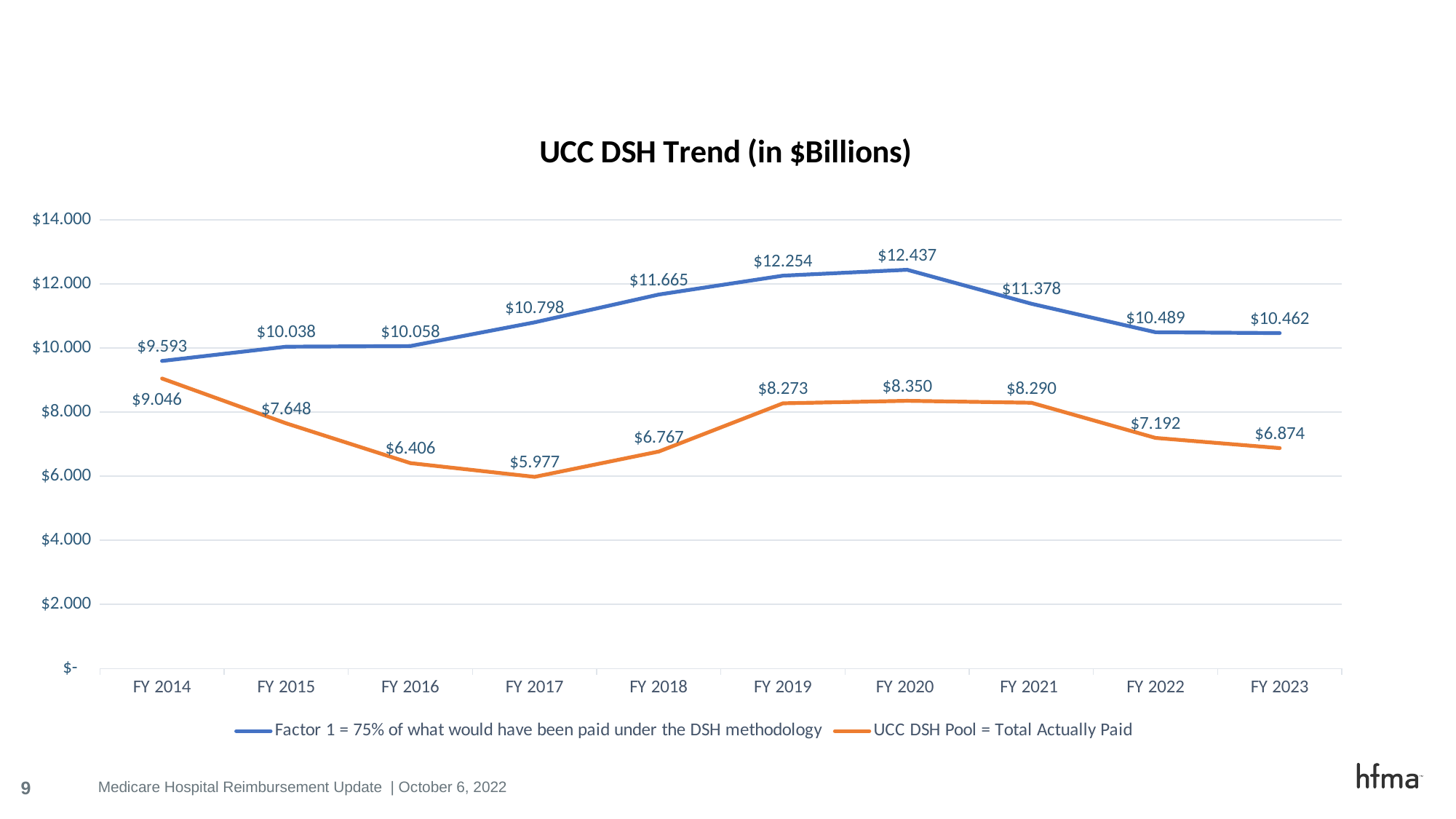
In which fiscal year is the UCC DSH Pool series lowest? FY 2017 What is the UCC DSH Pool value for FY 2023? $6.874 Which is larger in FY 2019: the Factor 1 value or the UCC DSH Pool value? Factor 1 What kind of chart is shown on the slide? Line chart What is the difference between the Factor 1 value and the UCC DSH Pool value in FY 2014? $0.547 How many fiscal years are plotted on the x axis? 10 What is the Factor 1 value for FY 2020? $12.437 What is the UCC DSH Pool value for FY 2017? $5.977 What is the title of the chart? UCC DSH Trend (in $Billions) Does the UCC DSH Pool series rise or fall from FY 2014 to FY 2017? Fall How many series does the legend list? 2 In which fiscal year is the Factor 1 series highest? FY 2020